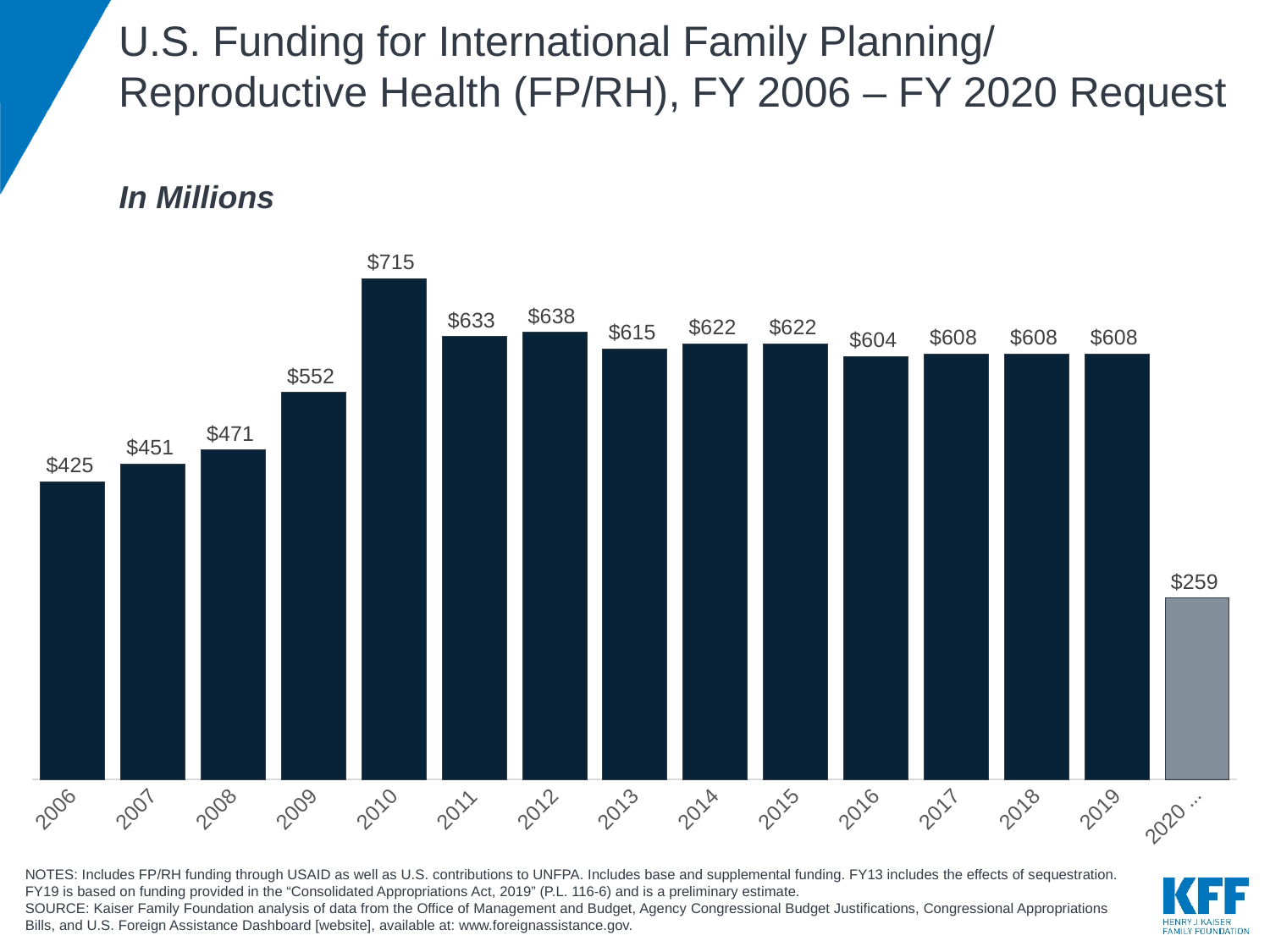
Which year has the highest value? 2010 What kind of chart is shown on the slide? Bar chart What is the difference between the values for 2010 and 2009? $163 What is the value for 2006? $425 How many bars are shown in the chart? 15 What is the difference between the values for 2019 and the 2020 Request? $349 Do the values rise or fall from 2006 to 2010? Rise Which bar has the lowest value? 2020 Request What is the value for the 2020 Request bar? $259 Which is larger, the value for 2012 or the value for 2013? 2012 What is the value for 2016? $604 What is the value for 2010? $715